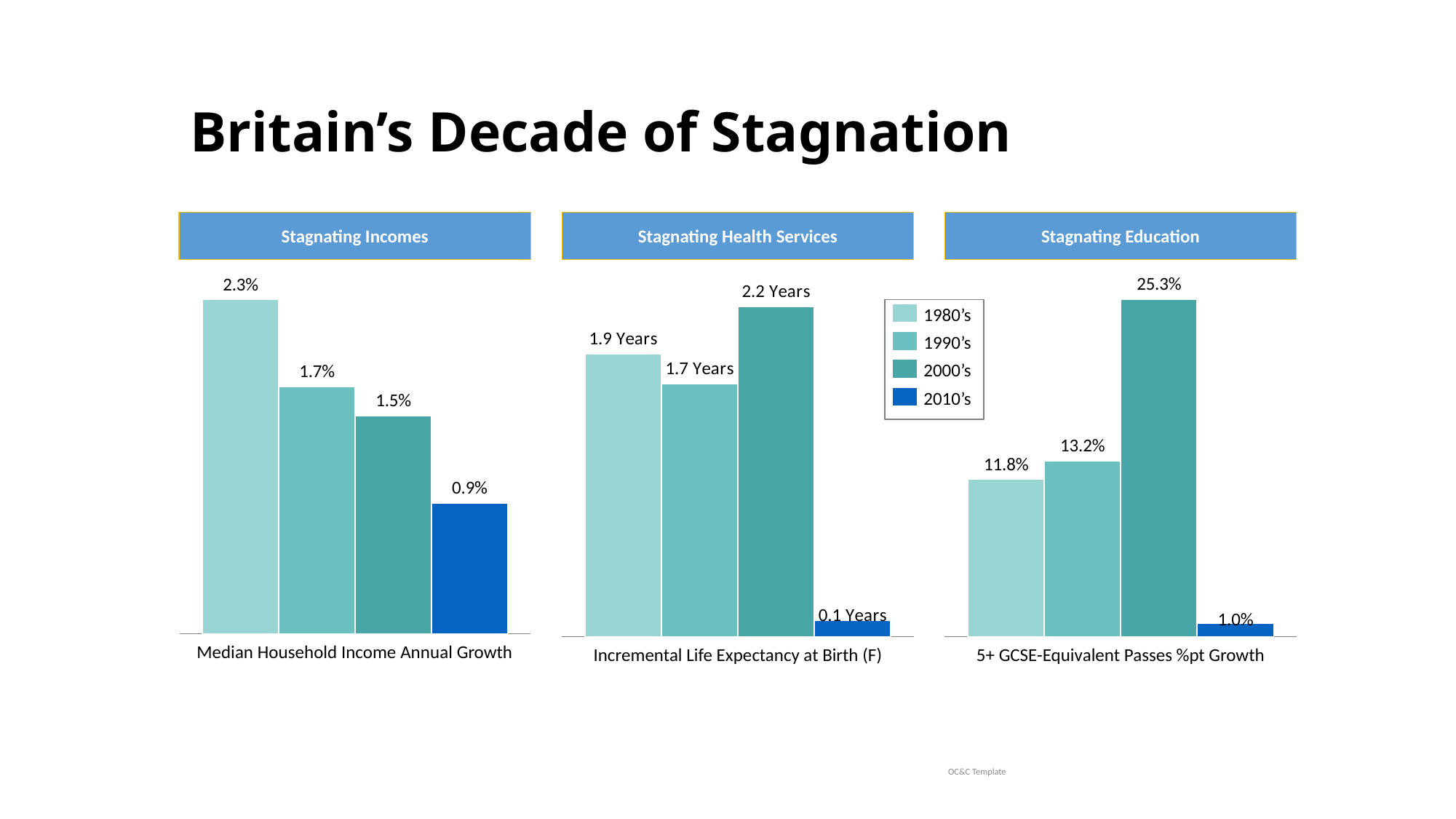
How many series does the legend list? 4 In the Stagnating Incomes chart, which decade has the highest value? 1980's In the Stagnating Health Services chart, which decade has the lowest value? 2010's In the Stagnating Health Services chart, what is the value for the 2000's? 2.2 Years In the Stagnating Education chart, what is the difference between the 1990's and 1980's values? 1.4% In the Stagnating Education chart, what is the value for the 2000's? 25.3% In the Stagnating Incomes chart, what is the value for the 2010's? 0.9% In the Stagnating Incomes chart, do the values rise or fall from the 1980's to the 2010's? fall In the Stagnating Incomes chart, what is the difference between the 1980's and 2010's values? 1.4% In the Stagnating Health Services chart, which is larger, the 1980's or the 1990's value? 1980's What type of chart is the Stagnating Education chart? bar chart In the Stagnating Education chart, which decade has the highest value? 2000's